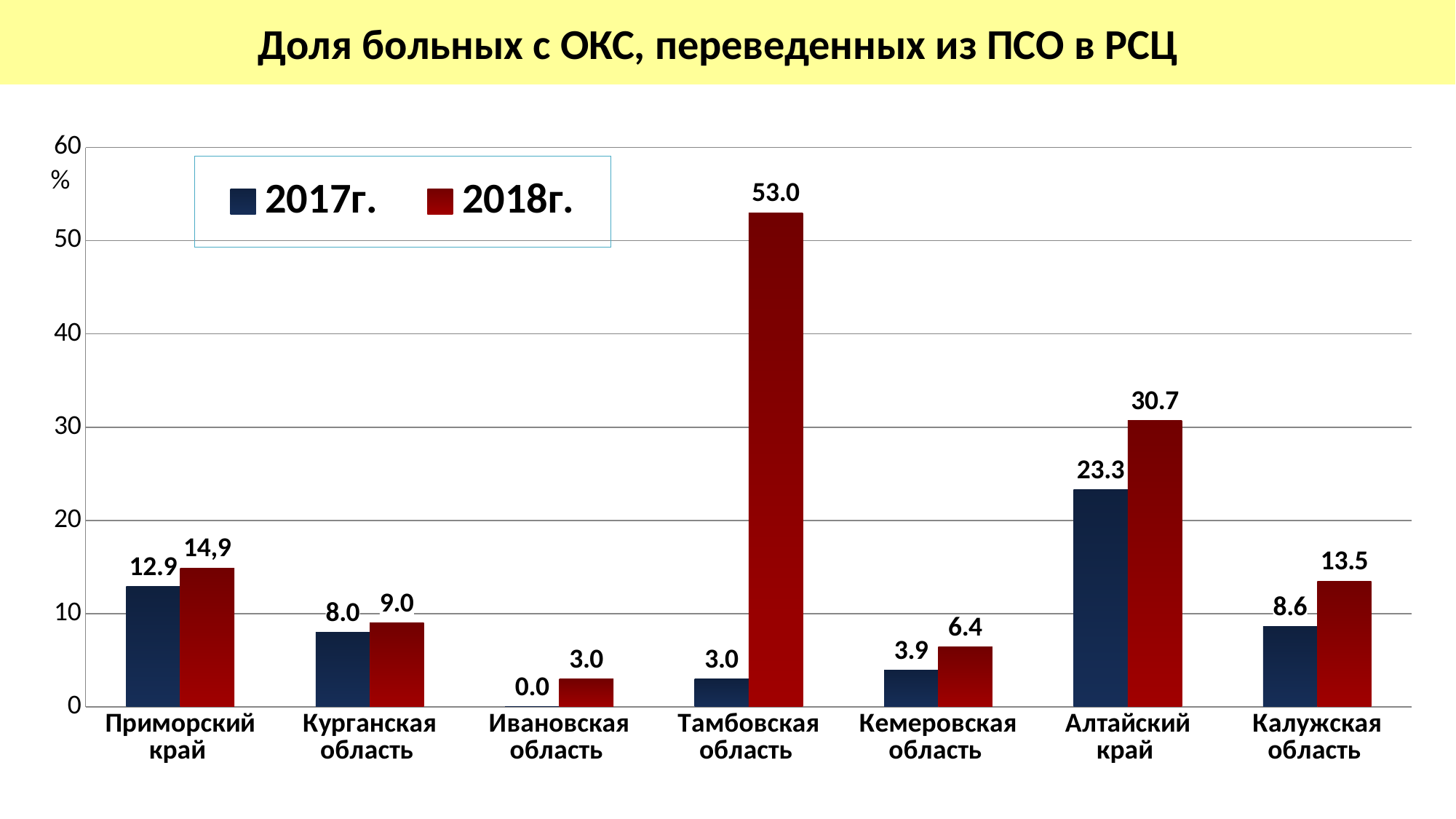
Which region has the highest 2018г. value? Тамбовская область Which region has the lowest 2017г. value? Ивановская область What is the difference between the 2018г. and 2017г. values for Тамбовская область? 50.0 How many series does the legend list? 2 What is the 2018г. value for Тамбовская область? 53.0 Is the 2018г. value for Тамбовская область greater or less than 50? greater What is the 2017г. value for Алтайский край? 23.3 What kind of chart is shown on the slide? bar chart What is the difference between the 2018г. and 2017г. values for Алтайский край? 7.4 Which is larger: the 2018г. value for Калужская область or the 2018г. value for Курганская область? Калужская область What is the 2018г. value for Приморский край? 14,9 How many regions are shown on the x axis? 7